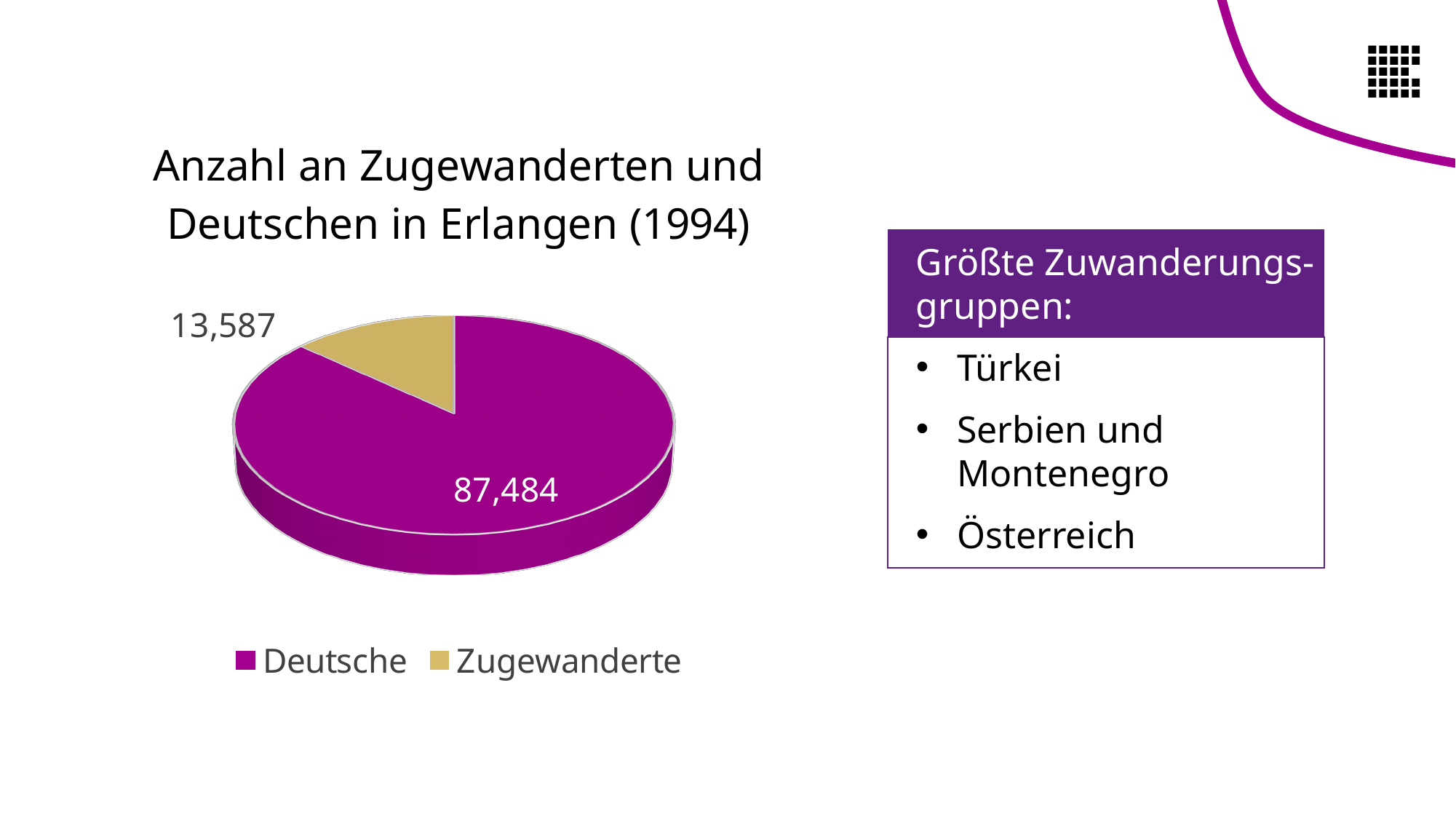
How many slices does the pie chart have? 2 What is the total of the two values shown in the pie chart? 101,071 What is the value for Deutsche in the pie chart? 87,484 How many entries does the legend of the pie chart list? 2 What is the difference between the value for Deutsche and the value for Zugewanderte? 73,897 What share of the pie does the Zugewanderte slice represent? 13.4% What is the value for Zugewanderte in the pie chart? 13,587 What kind of chart is shown on the slide? pie chart Which is larger, the value for Deutsche or the value for Zugewanderte? Deutsche Which category has the largest slice in the pie chart? Deutsche Which category has the smallest slice in the pie chart? Zugewanderte What is the title of the pie chart? Anzahl an Zugewanderten und Deutschen in Erlangen (1994)